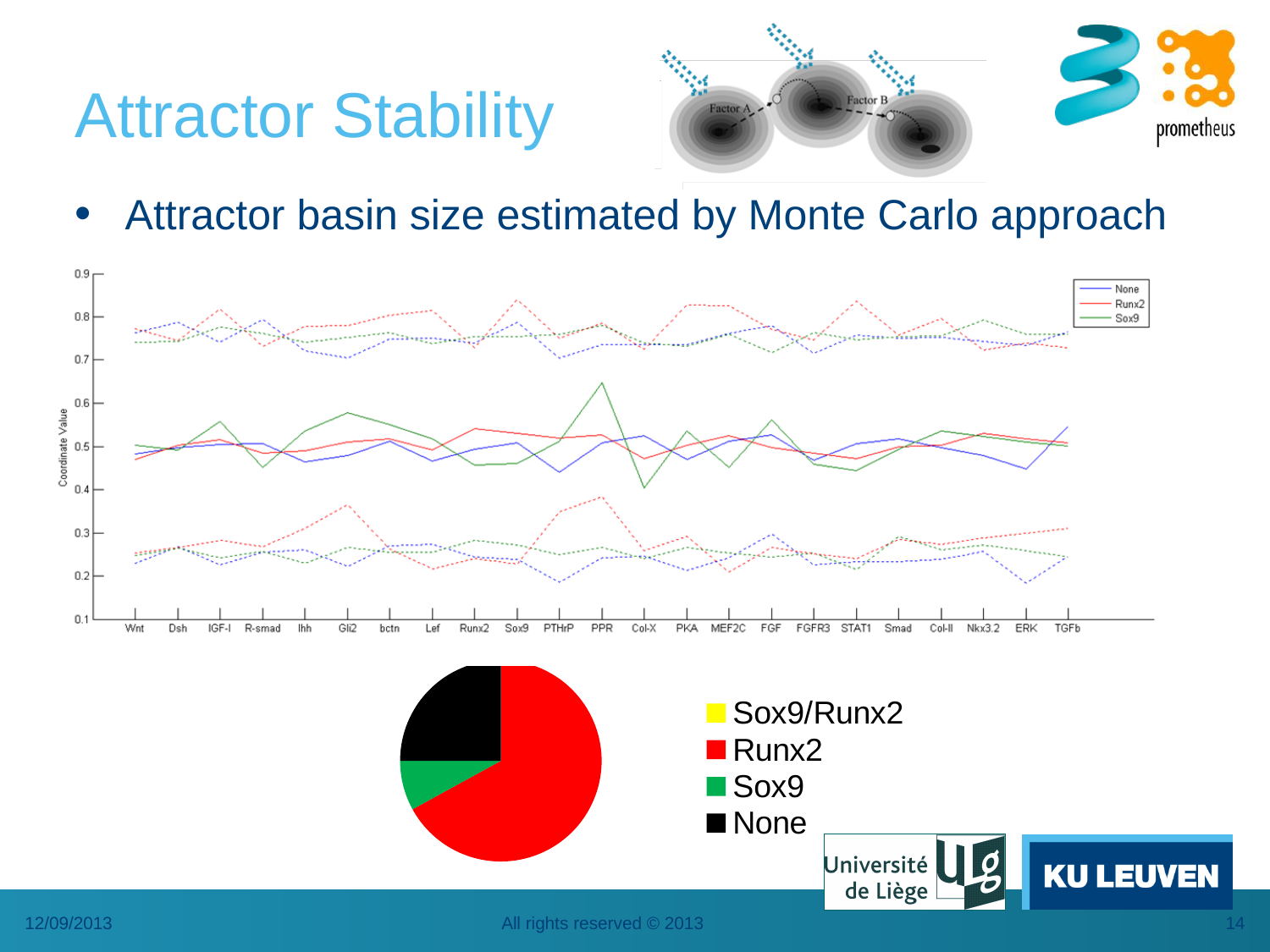
How many series does the legend of the top line chart list? 3 In the top line chart, is the value of the dotted Runx2 line at Gli2 greater or less than 0.3? greater In the top line chart, is the value of the solid Sox9 line at Col-X greater or less than 0.5? less How many categories are shown along the x axis of the top line chart? 23 In the bottom pie chart, what colour represents Sox9? green In the bottom pie chart, which slice is larger, None or Sox9? None In the bottom pie chart, which category has the largest slice? Runx2 In the top line chart, is the peak value of the solid Sox9 line at PPR greater or less than 0.6? greater What kind of chart is the top chart on the slide? line chart How many entries does the legend of the bottom pie chart list? 4 What kind of chart is the bottom chart on the slide? pie chart What is the label of the y axis of the top line chart? Coordinate Value